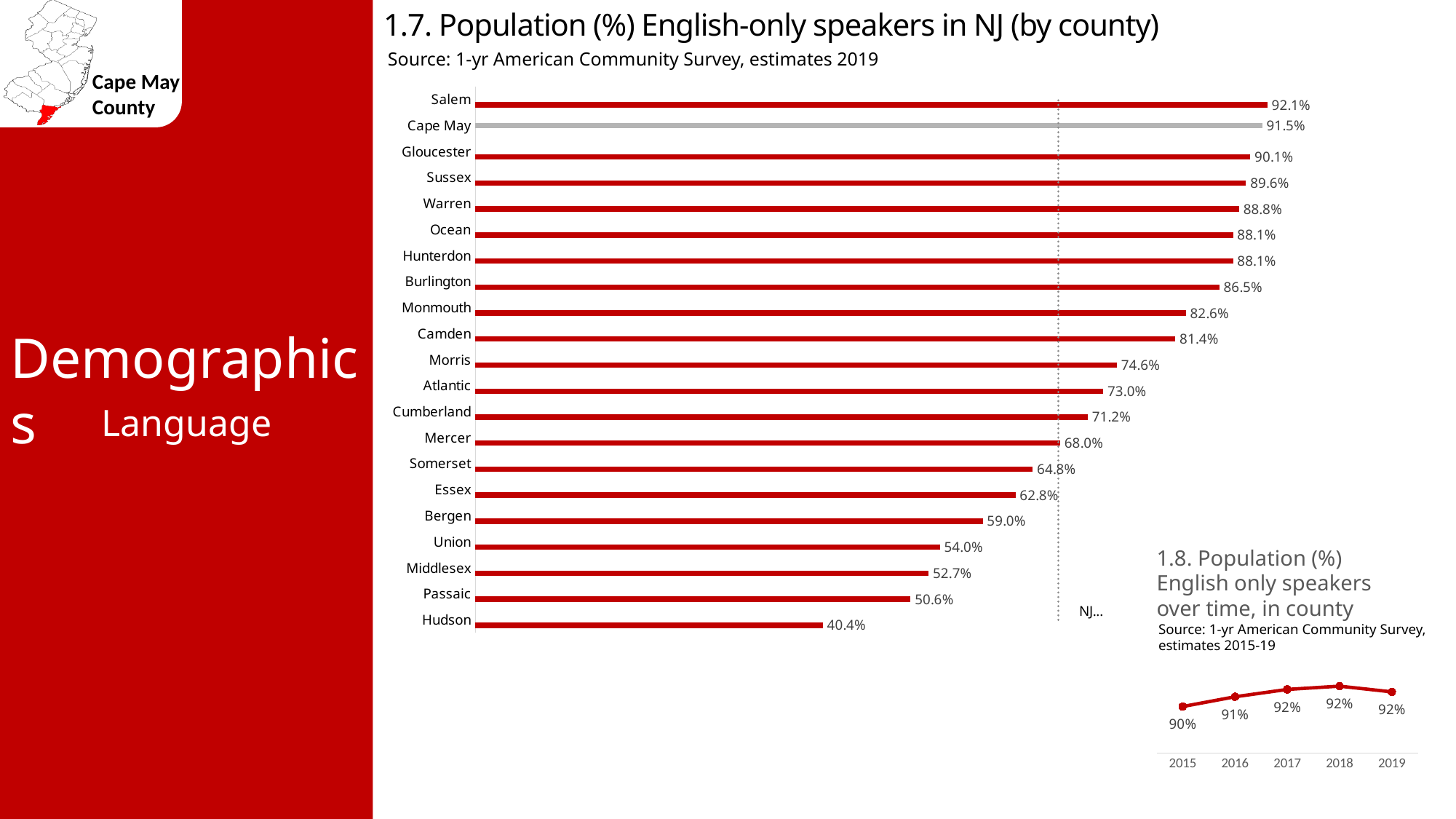
What kind of chart is chart 1.7? Bar chart In chart 1.8, do the values rise or fall from 2015 to 2017? Rise In chart 1.8 (Population (%) English only speakers over time, in county), what is the value for 2015? 90% In chart 1.7, which county has the highest percentage of English-only speakers? Salem In chart 1.8, how many years are plotted? 5 In chart 1.7, which county has the lowest percentage of English-only speakers? Hudson In chart 1.7, what is the difference between the values for Salem and Cape May? 0.6% In chart 1.7 (Population (%) English-only speakers in NJ by county), what is the value for Cape May? 91.5% In chart 1.7, what is the value for Mercer? 68.0% In chart 1.7, how many counties are plotted? 21 In chart 1.7, what is the value for Hudson? 40.4% In chart 1.7, which county has a larger value, Morris or Bergen? Morris